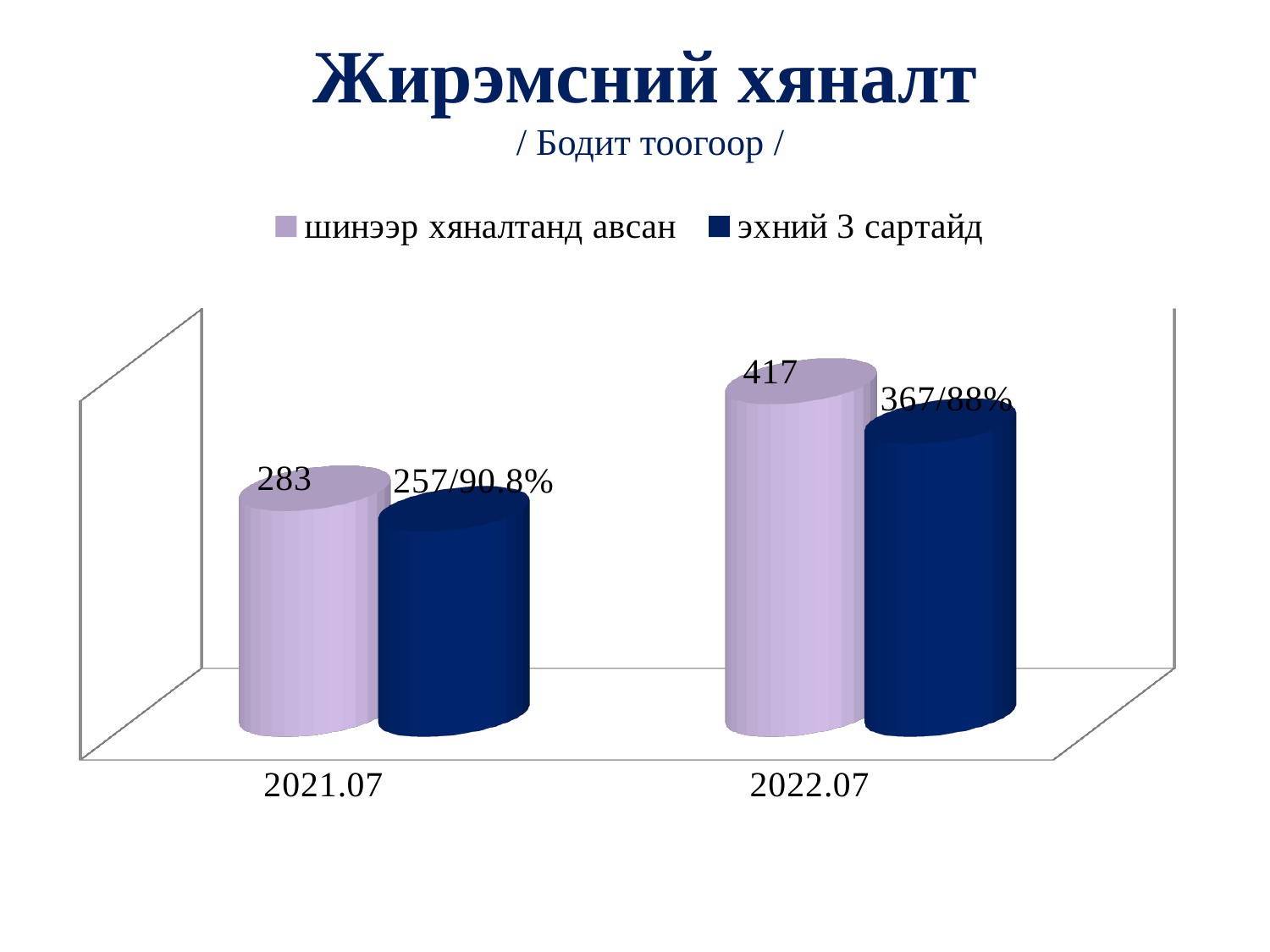
Which is larger in 2021.07: "шинээр хяналтанд авсан" or "эхний 3 сартайд"? шинээр хяналтанд авсан What is the value for "шинээр хяналтанд авсан" in 2022.07? 417 Which bar on the chart has the lowest value? эхний 3 сартайд in 2021.07 What is the difference between the two series' counts in 2022.07 (417 and 367)? 50 What type of chart is shown on the slide? Bar chart In which year is the value for "шинээр хяналтанд авсан" highest? 2022.07 How many categories are shown on the x axis? 2 What is the value for "шинээр хяналтанд авсан" in 2021.07? 283 What is the data label shown for "эхний 3 сартайд" in 2021.07? 257/90.8% What is the data label shown for "эхний 3 сартайд" in 2022.07? 367/88% By how much did "шинээр хяналтанд авсан" increase from 2021.07 to 2022.07? 134 How many series does the legend list? 2